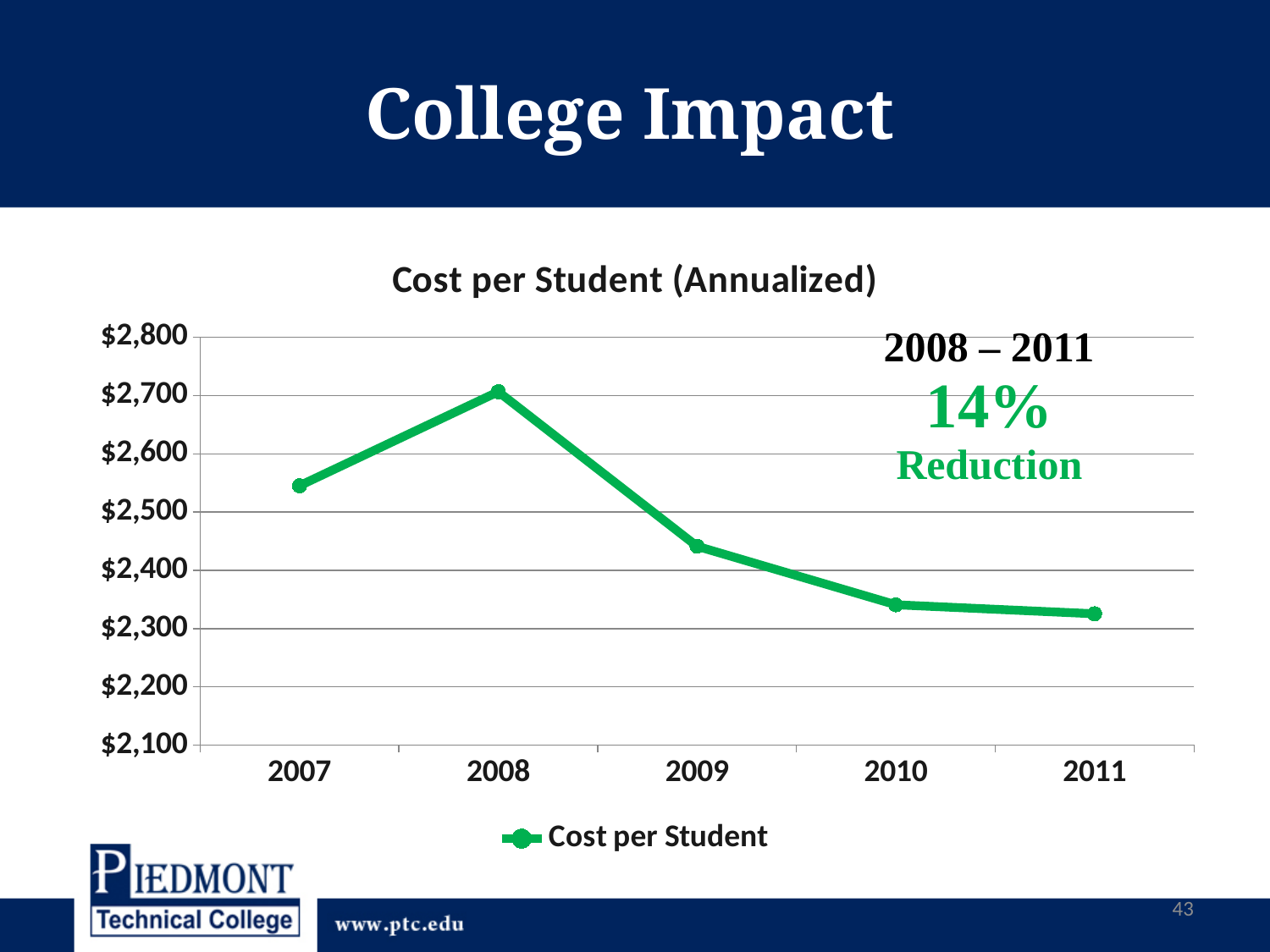
What percentage reduction does the annotation on the chart state for 2008 – 2011? 14% What is the title of the chart? Cost per Student (Annualized) How many series does the legend list? 1 Is the cost per student for 2010 greater or less than $2,400? less What type of chart is shown on the slide? Line chart How many years are plotted on the x axis? 5 Is the cost per student for 2011 greater or less than $2,300? greater Is the cost per student for 2007 greater or less than $2,500? greater Does the cost per student rise or fall from 2008 to 2011? Fall Which year has the highest cost per student? 2008 Which year has the higher cost per student, 2007 or 2009? 2007